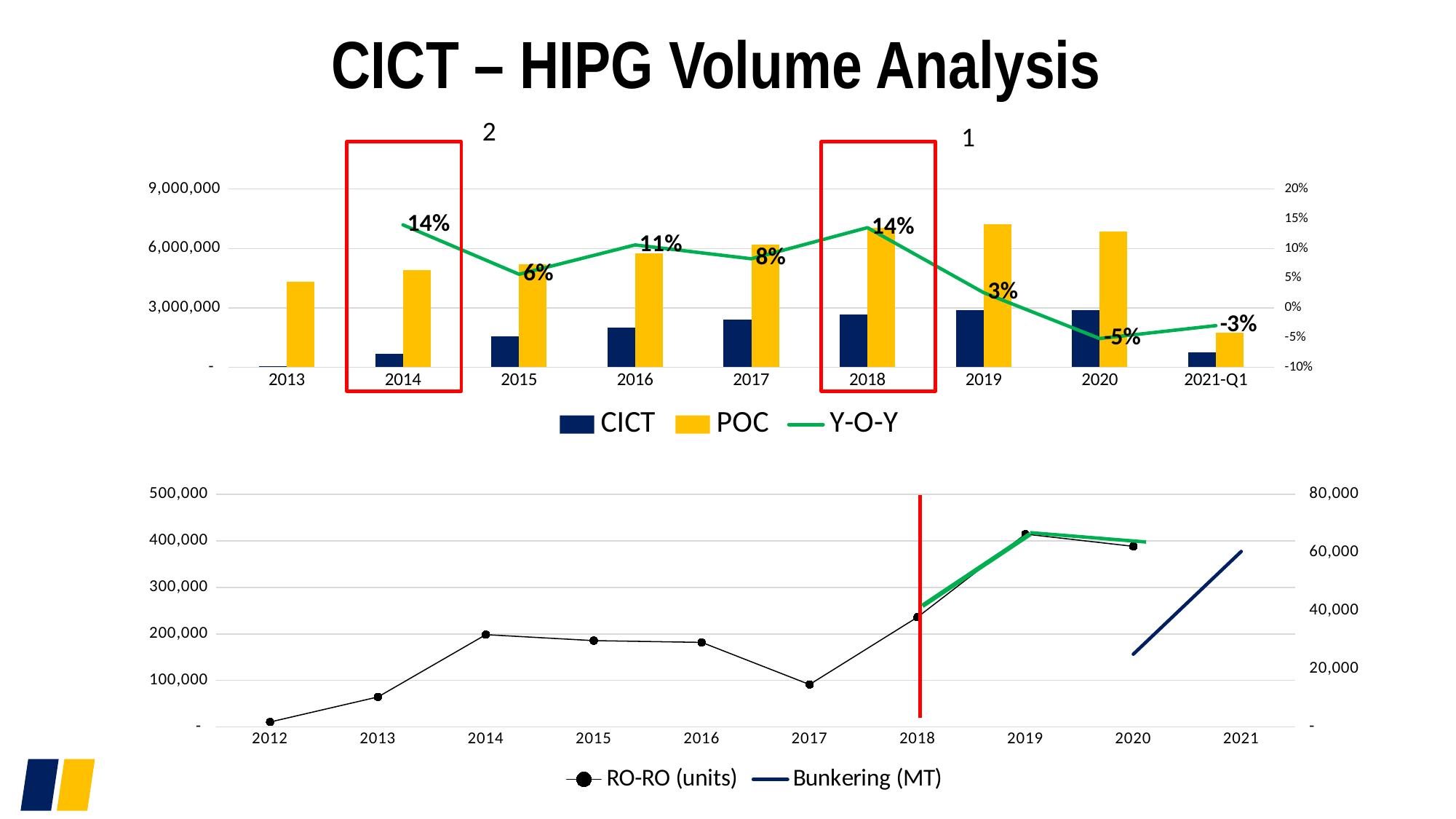
In the bottom chart, is the RO-RO (units) value for 2014 greater or less than 100,000? greater In the top chart, does the Y-O-Y line rise or fall from 2018 to 2020? fall In the top chart, which is larger, the POC value for 2013 or the POC value for 2014? 2014 How many series does the legend of the top chart list? 3 In the top chart, what is the Y-O-Y value for 2020? -5% In the top chart, which year has the lowest Y-O-Y value? 2020 In the top chart, is the POC value for 2019 greater or less than 6,000,000? greater How many series does the legend of the bottom chart list? 2 In the top chart, what is the Y-O-Y value for 2016? 11% In the top chart, is the CICT value for 2015 greater or less than 3,000,000? less In the top chart, what is the difference between the Y-O-Y values for 2014 and 2015? 8% In the bottom chart, which year has the highest RO-RO (units) value? 2019